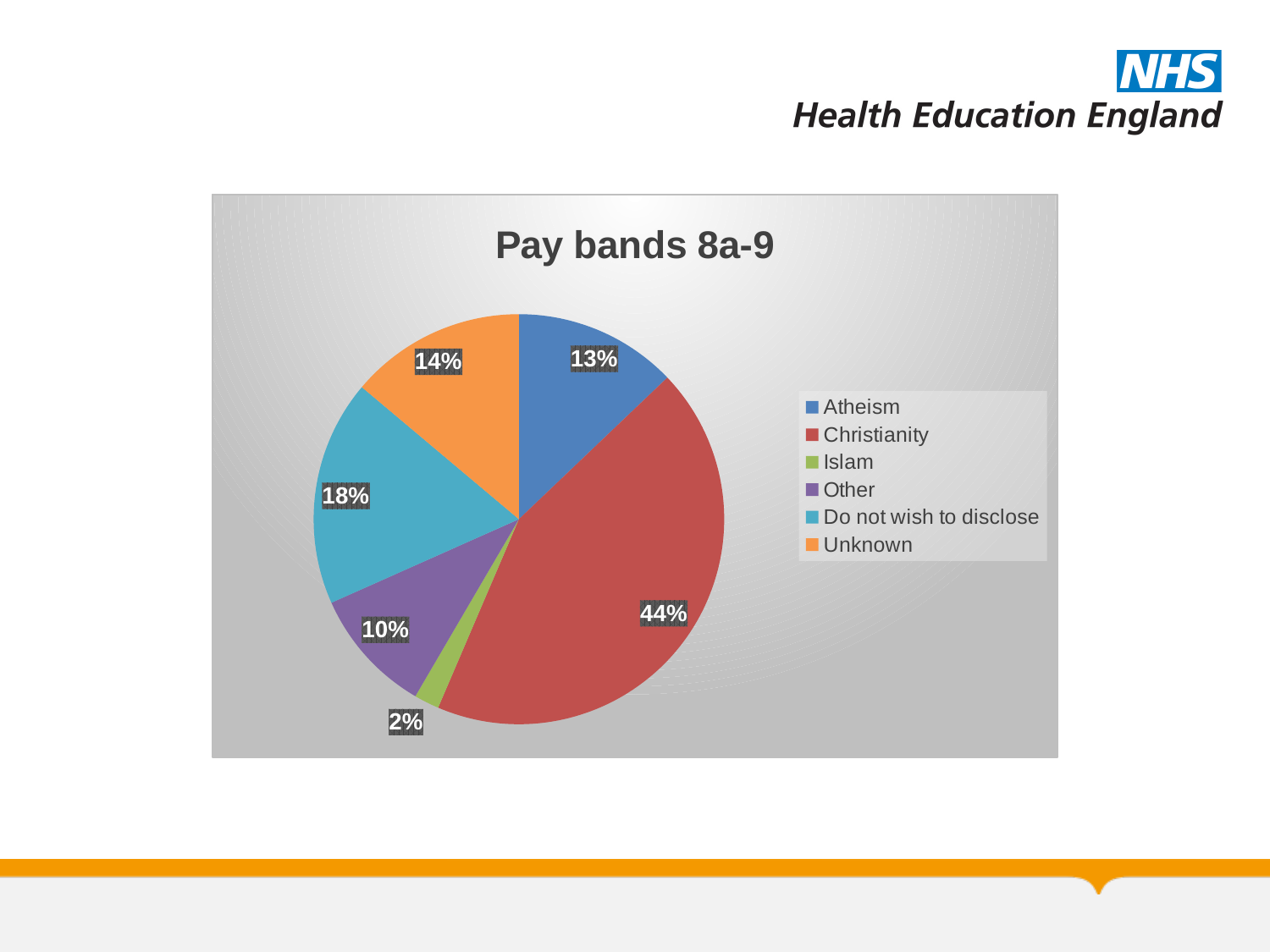
How many categories does the pie chart show? 6 What percentage of the pie is Do not wish to disclose? 18% What is the title of the chart? Pay bands 8a-9 What is the difference in percentage points between Christianity and Do not wish to disclose? 26 Which category has the largest share of the pie? Christianity Which is larger, the share for Unknown or the share for Other? Unknown What colour is the Unknown slice? Orange What percentage of the pie is Atheism? 13% What percentage of the pie is Christianity? 44% What kind of chart is shown on the slide? Pie chart What percentage of the pie is Islam? 2% Which category has the smallest share of the pie? Islam